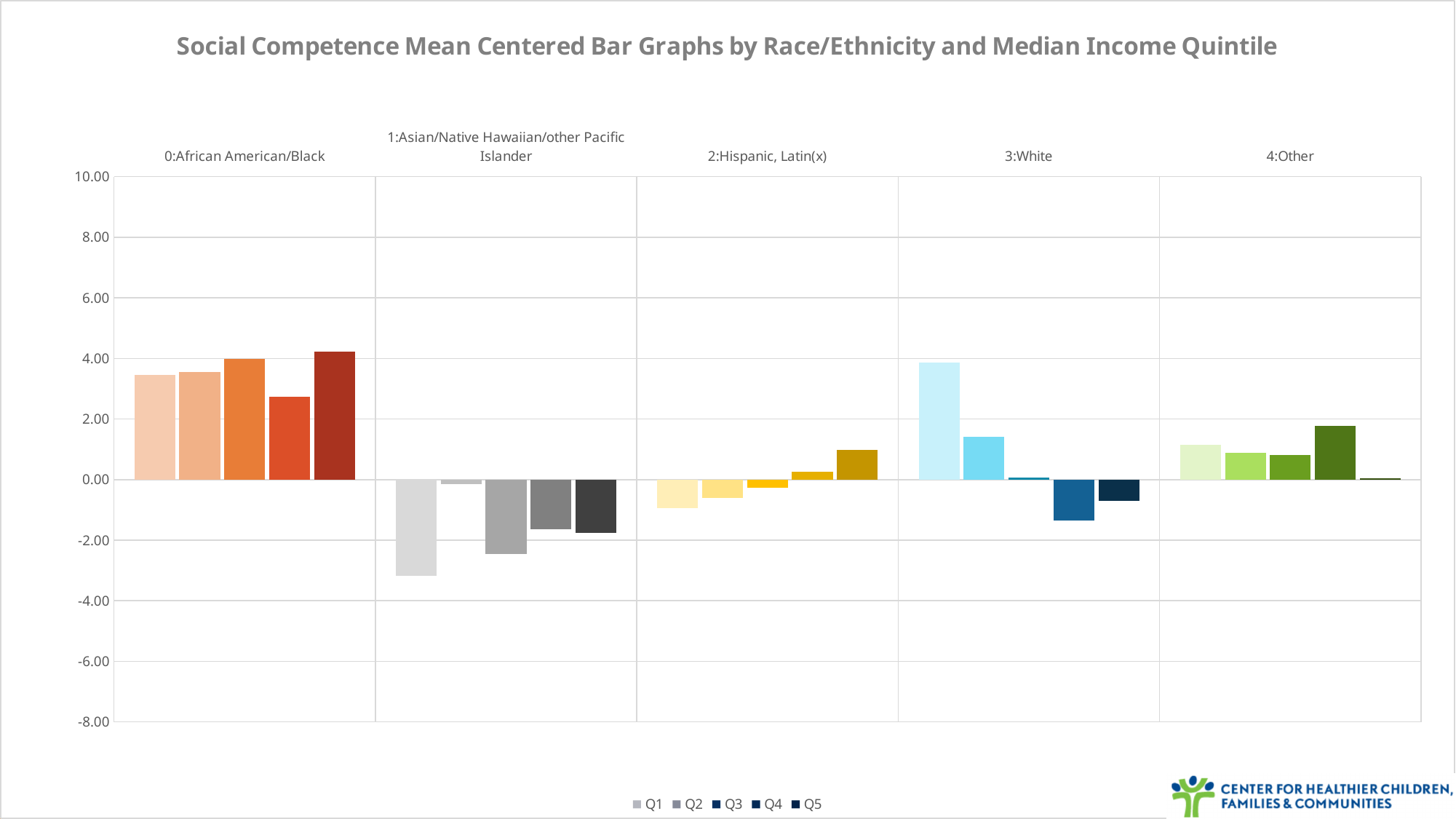
What kind of chart is shown on the slide? Bar chart How many series does the legend list? 5 How many race/ethnicity groups are shown along the x axis? 5 Which is larger, the Q4 value for 3:White or the Q4 value for 4:Other? 4:Other Do the values for 2:Hispanic, Latin(x) rise or fall from Q1 to Q5? rise Within the 1:Asian/Native Hawaiian/other Pacific Islander group, which quintile has the lowest value? Q1 Within the 3:White group, which quintile has the highest value? Q1 Is the Q1 value for 3:White greater or less than 2.00? greater Within the 0:African American/Black group, which quintile has the highest value? Q5 Is the Q1 value for 1:Asian/Native Hawaiian/other Pacific Islander greater or less than -2.00? less What are the entries listed in the legend? Q1, Q2, Q3, Q4, Q5 Is the Q4 value for 4:Other greater or less than 1.00? greater